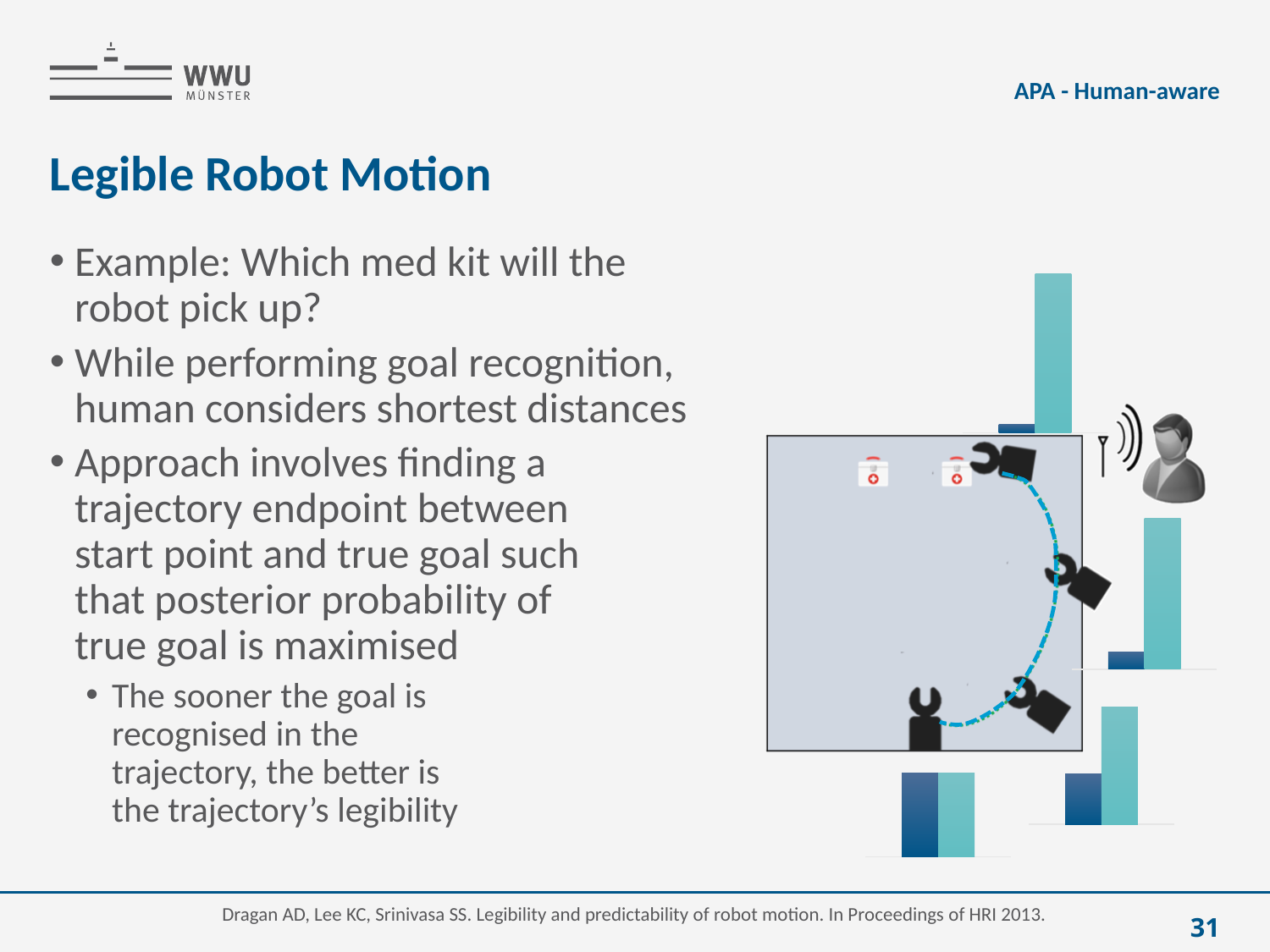
In the bottom-right bar chart, which bar is shorter, the dark blue one or the teal one? dark blue In the bottom-left bar chart (below the robot diagram), which bar is taller, the dark blue one or the teal one? Neither; the dark blue and teal bars are the same height What two colours are used for the bars in the small bar charts on the slide? dark blue and teal In the top bar chart (next to the person icon), which bar is taller, the dark blue one or the teal one? teal How many bars does each small bar chart on the slide contain? 2 How many small bar charts are shown on the right side of the slide? 4 What kind of chart is shown in the small charts on the right side of the slide? bar chart Do the small bar charts on the slide show any axis labels or data values? No